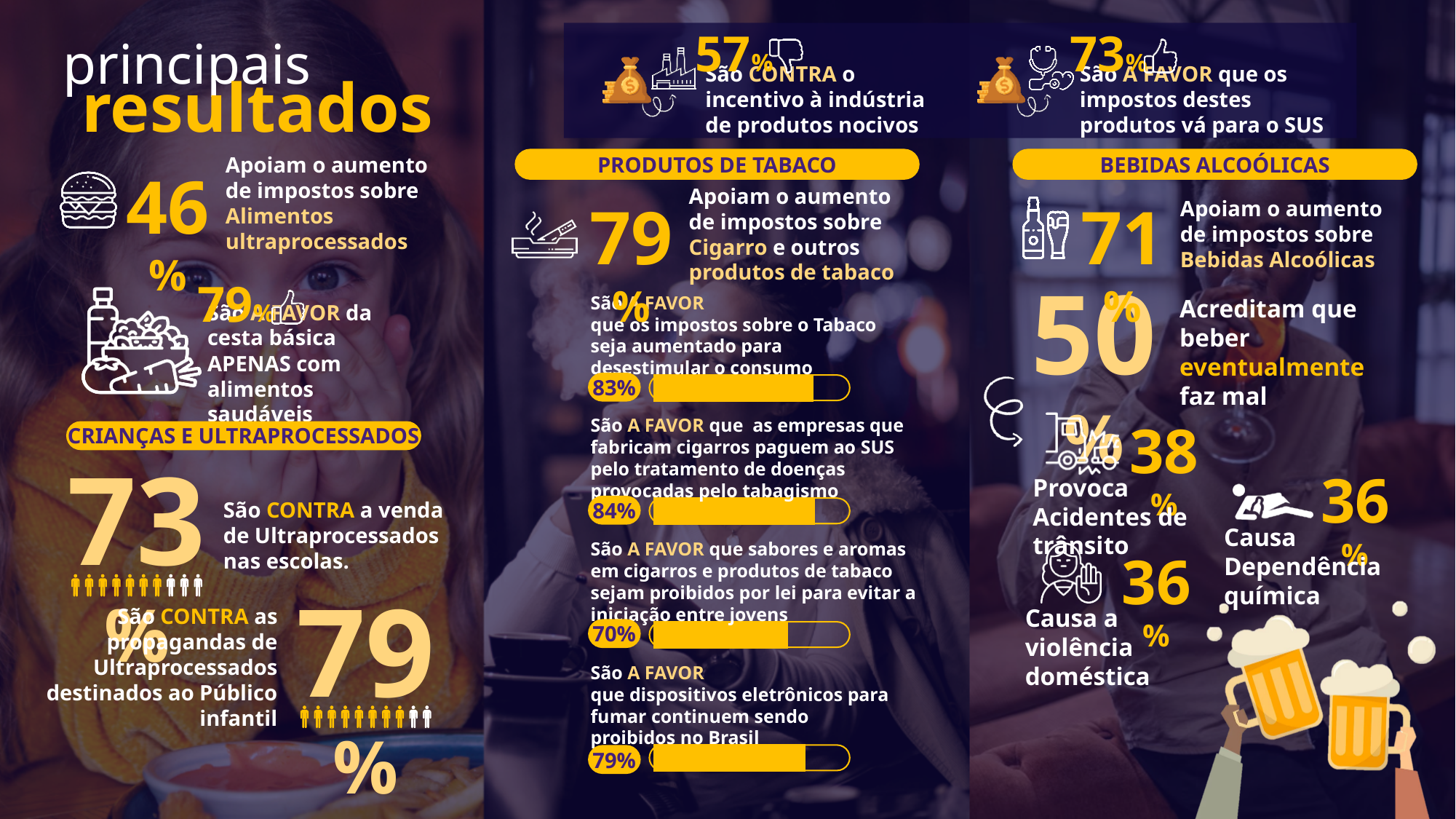
What colour are the filled portions of the progress bars in the PRODUTOS DE TABACO section? Yellow How many progress bars are shown in the PRODUTOS DE TABACO section? 4 In the PRODUTOS DE TABACO progress bars, what percentage are in favour of raising tobacco taxes to discourage consumption? 83% In the PRODUTOS DE TABACO progress bars, which is larger: the value for raising tobacco taxes (83%) or the value for keeping electronic devices banned (79%)? Raising tobacco taxes (83%) In the PRODUTOS DE TABACO progress bars, what is the difference between the highest value (84%) and the lowest value (70%)? 14 percentage points Among the four PRODUTOS DE TABACO progress bars, which statement has the lowest percentage? Banning flavours and aromas in cigarettes (70%) In the PRODUTOS DE TABACO progress bars, what percentage are in favour of electronic smoking devices remaining banned in Brazil? 79% Among the four PRODUTOS DE TABACO progress bars, which statement has the highest percentage? Cigarette manufacturers paying the SUS (84%) In the CRIANÇAS E ULTRAPROCESSADOS section, what percentage are against the sale of ultra-processed foods in schools, as shown with the people pictogram? 73% In the PRODUTOS DE TABACO progress bars, what percentage are in favour of cigarette manufacturers paying the SUS for treating smoking-related diseases? 84% What kind of chart is used in the PRODUTOS DE TABACO section to show the percentages? Bar chart (horizontal progress bars) In the PRODUTOS DE TABACO progress bars, what percentage are in favour of banning flavours and aromas in cigarettes and tobacco products? 70%